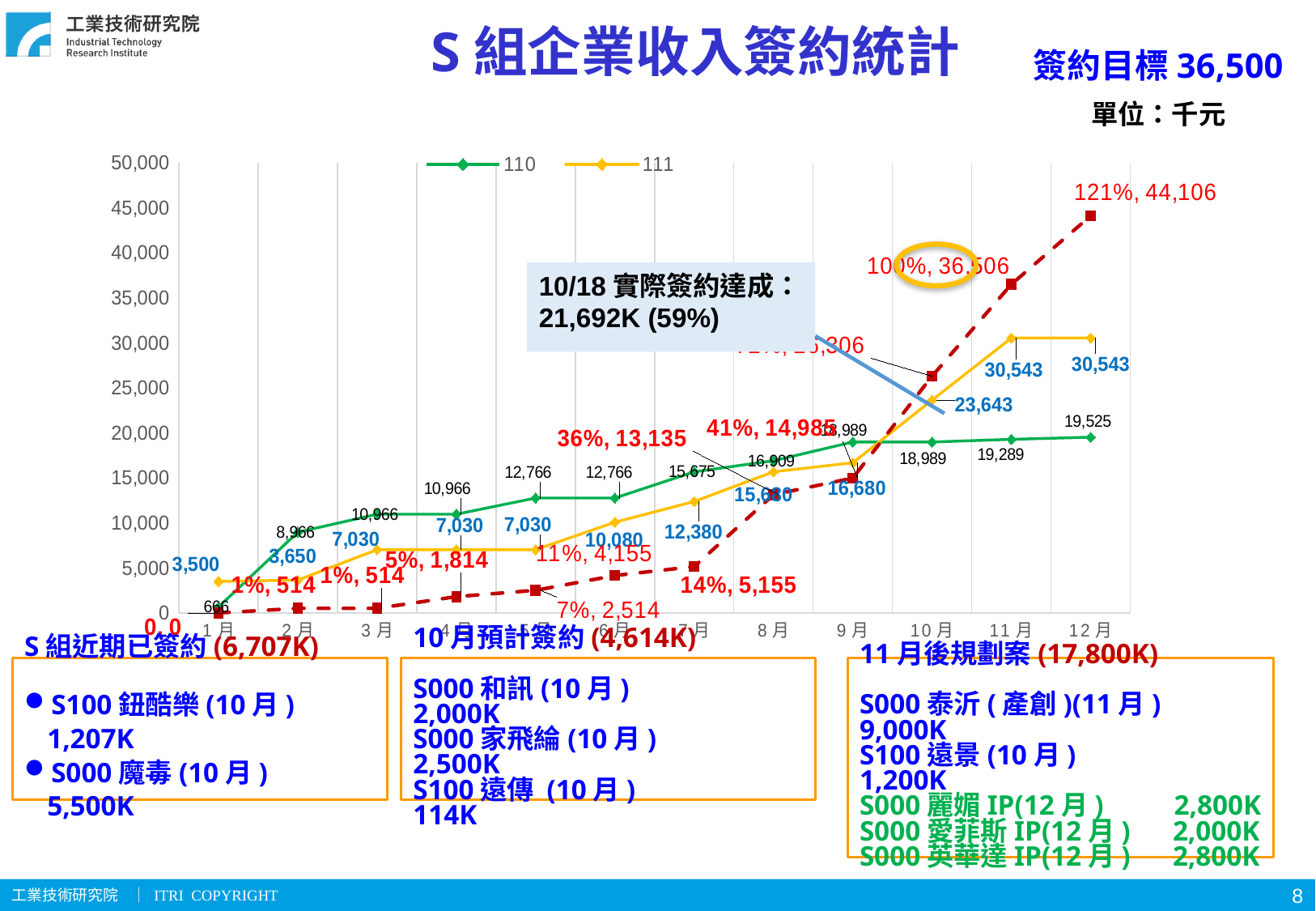
What is the value of the 111 series in 11月? 30,543 How many months are shown along the x axis of the chart? 12 What is the value of the 110 series in 12月? 19,525 Does the 111 series rise or fall from 1月 to 12月? rise What kind of chart is shown on the slide? line chart Is the value of the 111 series in 11月 greater or less than 25,000? greater What is the value of the 110 series in 2月? 8,966 In 5月, which series has the larger value, 110 or 111? 110 How many series does the chart legend list? 2 What is the 簽約目標 (contract target) stated on the slide? 36,500 What is the difference between the 111 series and the 110 series in 12月? 11,018 What is the value of the 111 series in 10月? 23,643